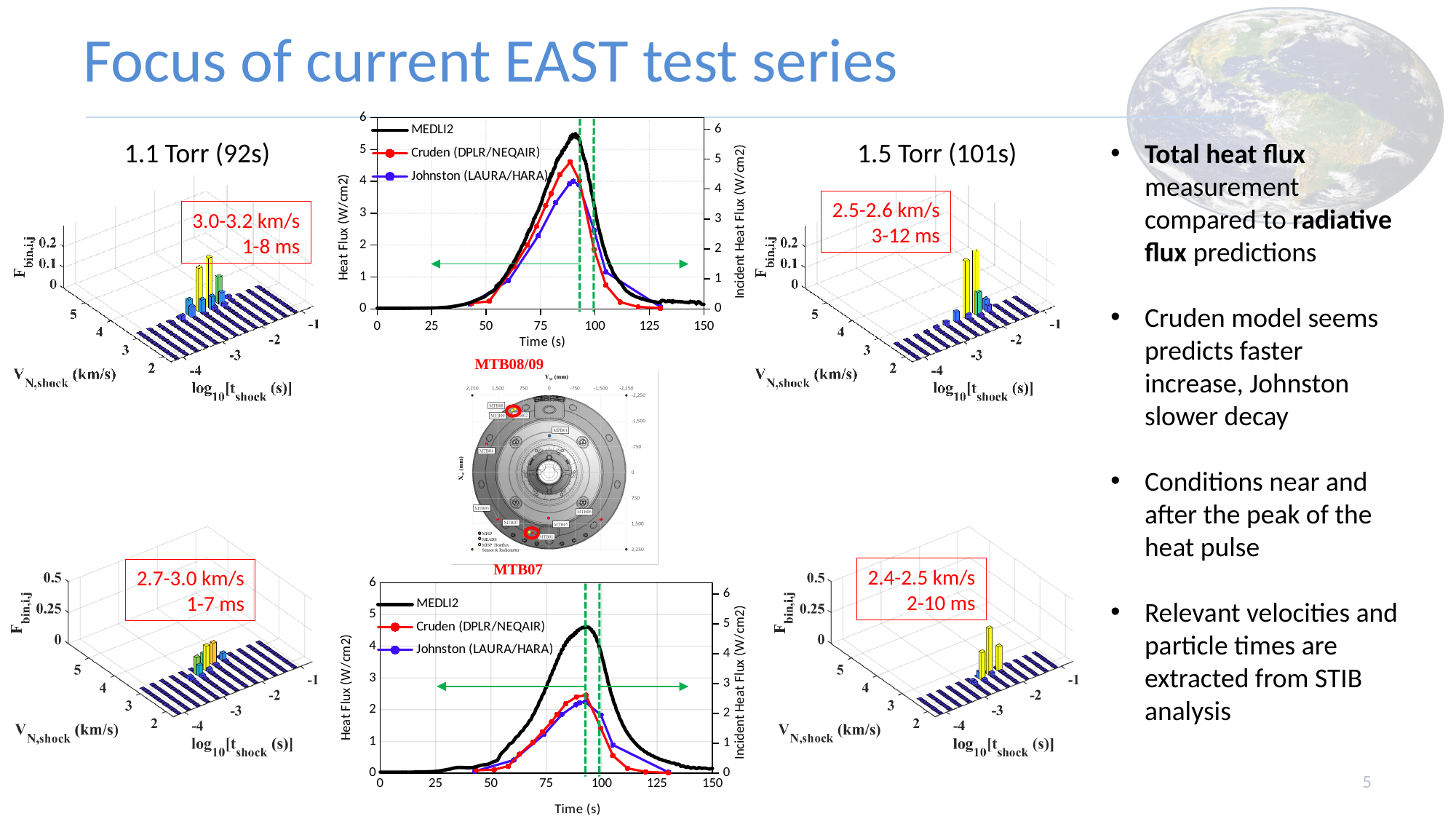
In the MTB08/09 chart, is the peak value of the MEDLI2 series greater or less than 5 W/cm2? greater In the MTB08/09 chart, which series reaches the higher peak, MEDLI2 or Johnston (LAURA/HARA)? MEDLI2 In the MTB07 chart, is the peak value of the MEDLI2 series greater or less than 5 W/cm2? less In the MTB07 chart, which series reaches the higher peak, MEDLI2 or Cruden (DPLR/NEQAIR)? MEDLI2 How many series does the legend of the MTB07 chart list? 3 In the MTB07 chart, is the peak value of the Cruden (DPLR/NEQAIR) series greater or less than 3 W/cm2? less What kind of chart is the MTB08/09 chart in the top centre of the slide? line chart In the MTB08/09 chart, which series has the highest peak heat flux? MEDLI2 What is the x-axis label of the MTB07 chart? Time (s) What velocity range is annotated on the 1.1 Torr (92s) 3D bar chart at the top left? 3.0-3.2 km/s In the MTB07 chart, does the MEDLI2 heat flux rise or fall between 50 s and 90 s? rise